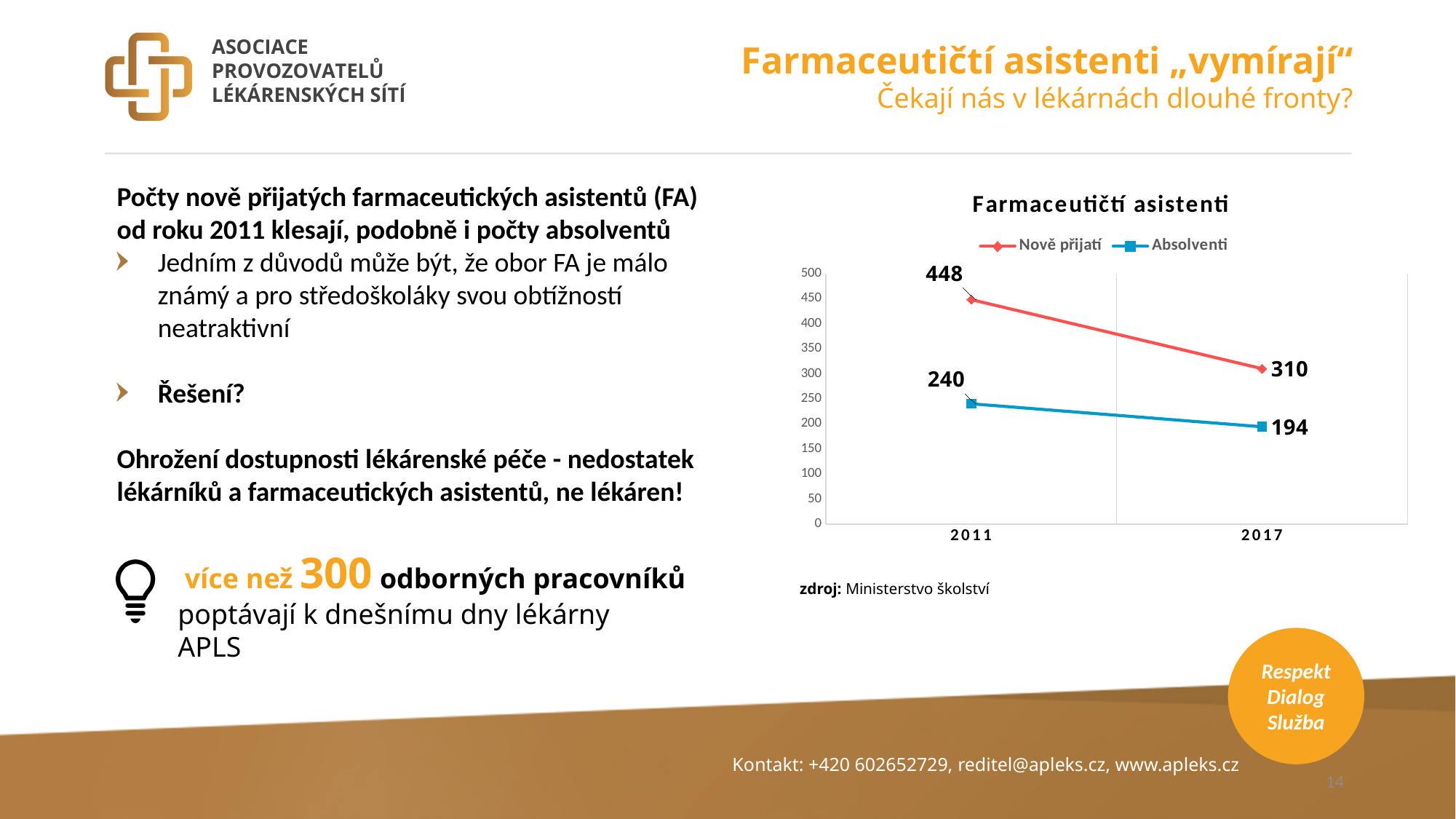
What is the title of the chart? Farmaceutičtí asistenti What is the value for Absolventi in 2017? 194 Does the value for Nově přijatí rise or fall from 2011 to 2017? fall What kind of chart is shown on the slide? line chart By how much did Nově přijatí decrease from 2011 to 2017? 138 What is the value for Nově přijatí in 2011? 448 By how much did Absolventi decrease from 2011 to 2017? 46 Which series has the higher value in 2017, Nově přijatí or Absolventi? Nově přijatí What is the value for Absolventi in 2011? 240 What is the value for Nově přijatí in 2017? 310 How many series does the legend list? 2 How many years are shown on the x axis? 2